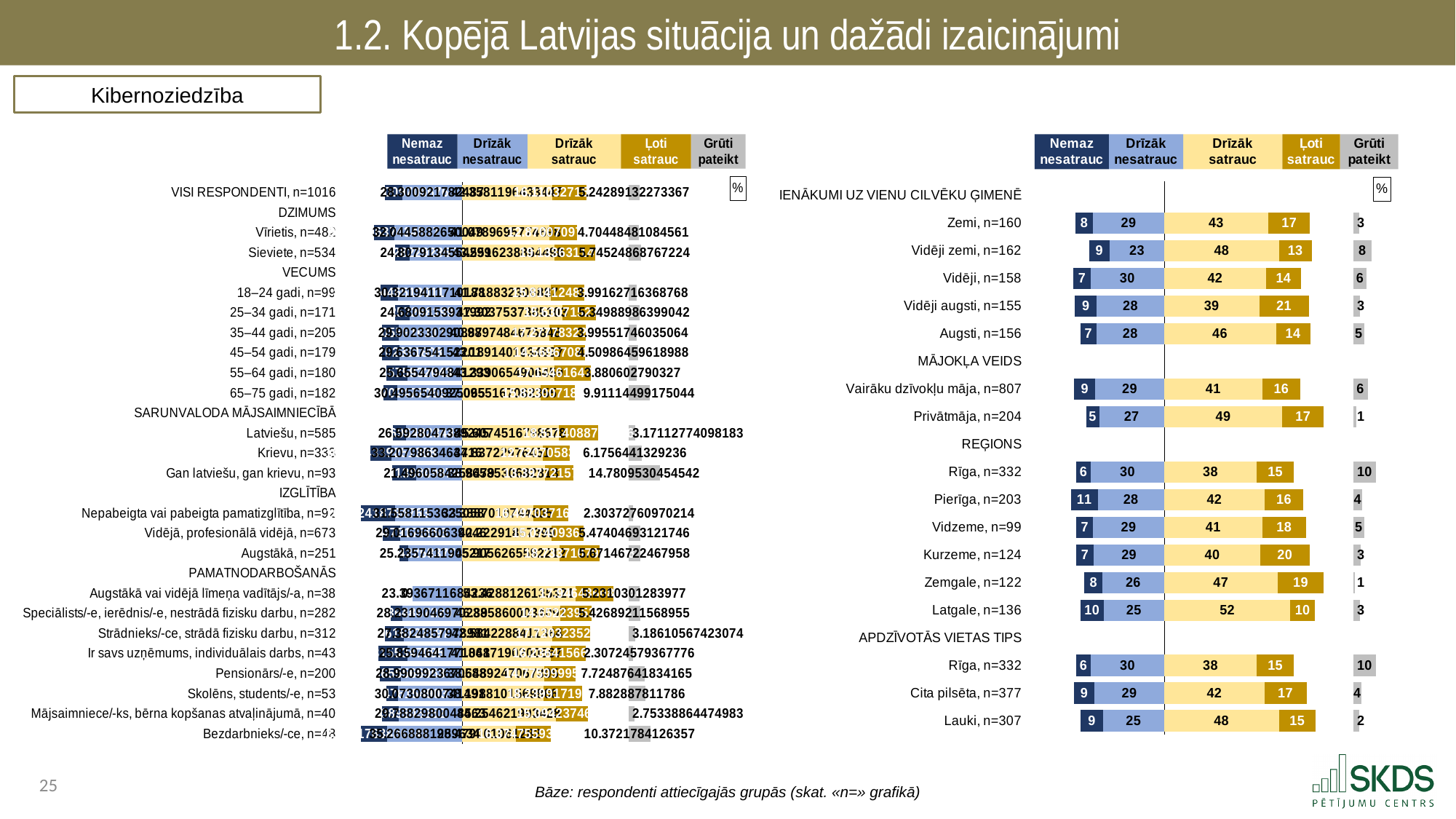
In the chart on the right, which legend entry is shown in dark gold/orange? Ļoti satrauc In the chart on the right, what is the total of the stacked bar for Zemi, n=160? 100 What kind of chart is the chart on the right? Stacked bar chart In the chart on the right, what is the 'Grūti pateikt' value for Rīga, n=332 under REĢIONS? 10 In the chart on the right, which region under REĢIONS has the lowest 'Ļoti satrauc' value? Latgale, n=136 In the chart on the right, what is the 'Ļoti satrauc' value for Vidēji augsti, n=155? 21 In the chart on the right, which region under REĢIONS has the highest 'Drīzāk satrauc' value? Latgale, n=136 In the chart on the right, what is the difference between the 'Drīzāk satrauc' values for Privātmāja, n=204 and Vairāku dzīvokļu māja, n=807? 8 In the chart on the right, what is the 'Nemaz nesatrauc' value for Pierīga, n=203? 11 In the chart on the right, which has the larger 'Ļoti satrauc' value: Kurzeme, n=124 or Vidzeme, n=99? Kurzeme, n=124 In the chart on the right, what is the 'Drīzāk satrauc' value for Latgale, n=136? 52 How many series does the legend of the chart on the right list? 5